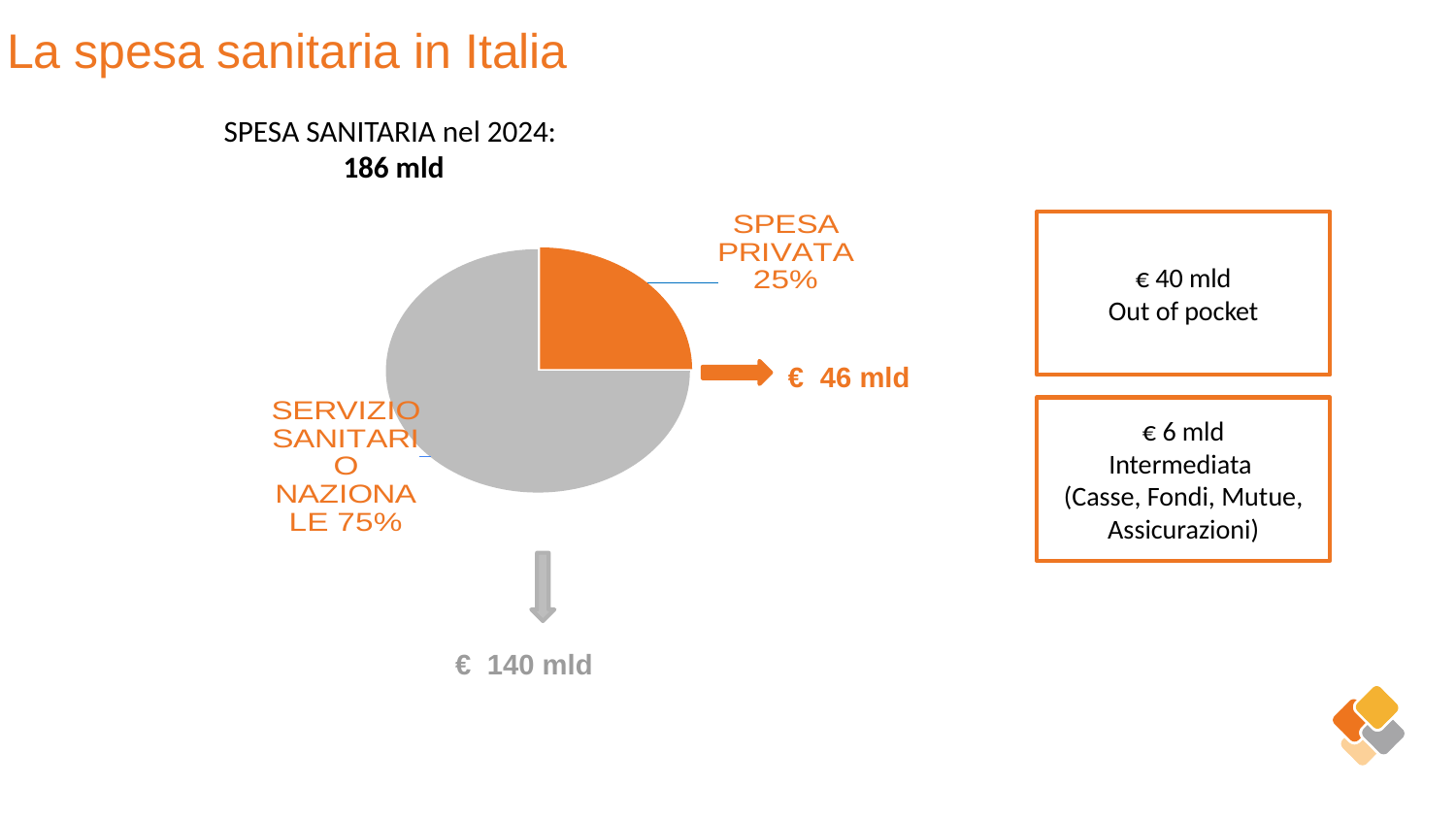
Which is larger, the share for SPESA PRIVATA or the share for SERVIZIO SANITARIO NAZIONALE? SERVIZIO SANITARIO NAZIONALE Which slice of the pie chart is the smallest? SPESA PRIVATA What is the total health expenditure for 2024 stated above the pie chart? 186 mld What kind of chart is shown on the slide? Pie chart What share of the pie does SPESA PRIVATA represent? 25% How many slices does the pie chart have? 2 What colour is the SPESA PRIVATA slice of the pie chart? Orange What amount in mld is shown for the SERVIZIO SANITARIO NAZIONALE slice? € 140 mld What share of the pie does SERVIZIO SANITARIO NAZIONALE represent? 75% What amount in mld is shown for the SPESA PRIVATA slice? € 46 mld Which slice of the pie chart is the largest? SERVIZIO SANITARIO NAZIONALE What is the difference in percentage points between the SERVIZIO SANITARIO NAZIONALE share and the SPESA PRIVATA share? 50 percentage points